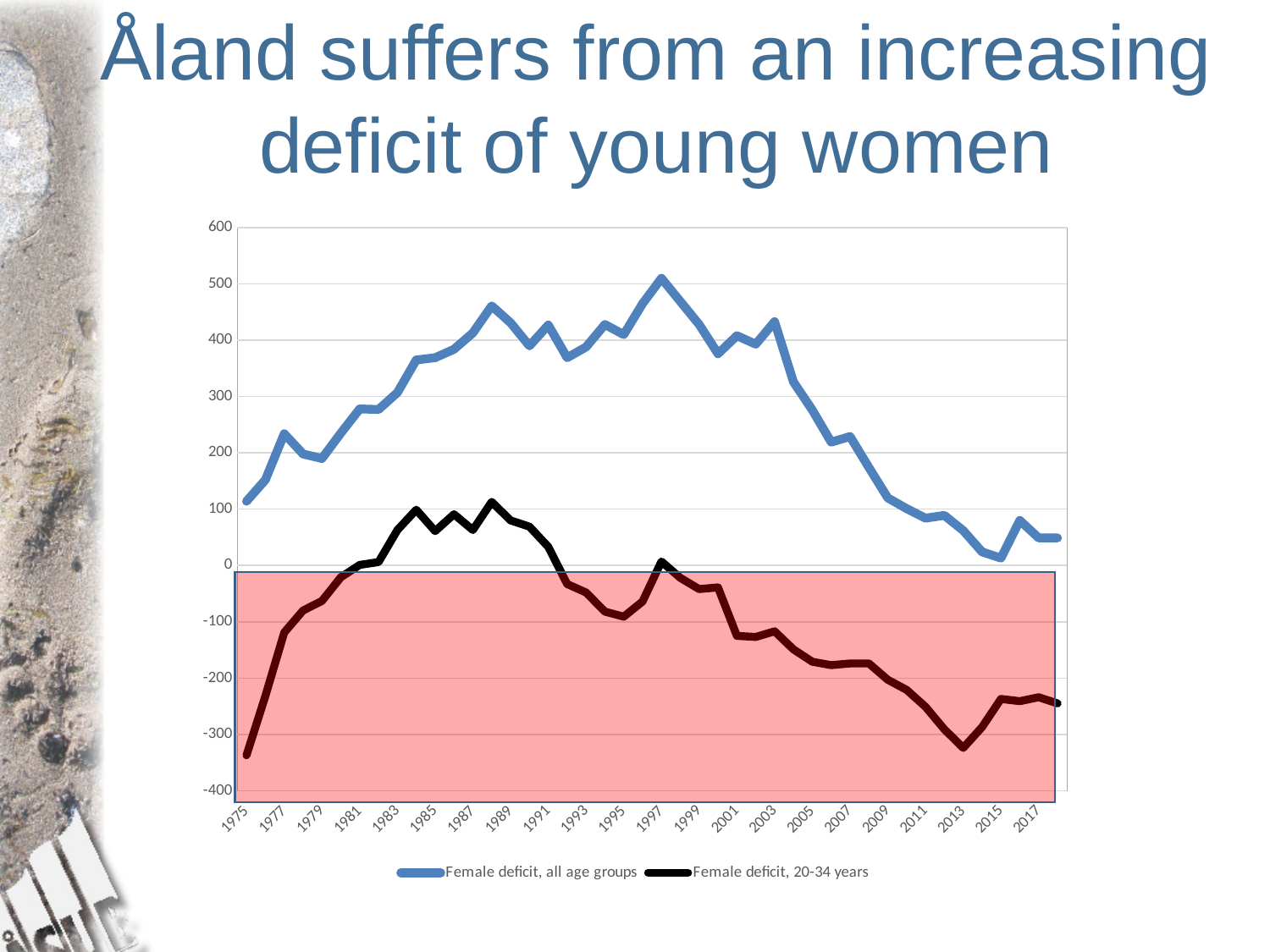
What colour is the line for 'Female deficit, 20-34 years'? black What are the two series named in the legend? Female deficit, all age groups; Female deficit, 20-34 years Is the value for 'Female deficit, all age groups' in 2017 greater or less than 100? less Does the 'Female deficit, all age groups' line rise or fall between 2003 and 2013? fall In 1997, which series has the larger value: 'Female deficit, all age groups' or 'Female deficit, 20-34 years'? Female deficit, all age groups In which year does the 'Female deficit, all age groups' line reach its highest value? 1997 How many series does the legend list? 2 Is the value for 'Female deficit, 20-34 years' in 1975 greater or less than -300? less Is the value for 'Female deficit, all age groups' in 1997 greater or less than 500? greater In which year is the 'Female deficit, 20-34 years' line at its lowest value? 1975 What kind of chart is shown on the slide? line chart